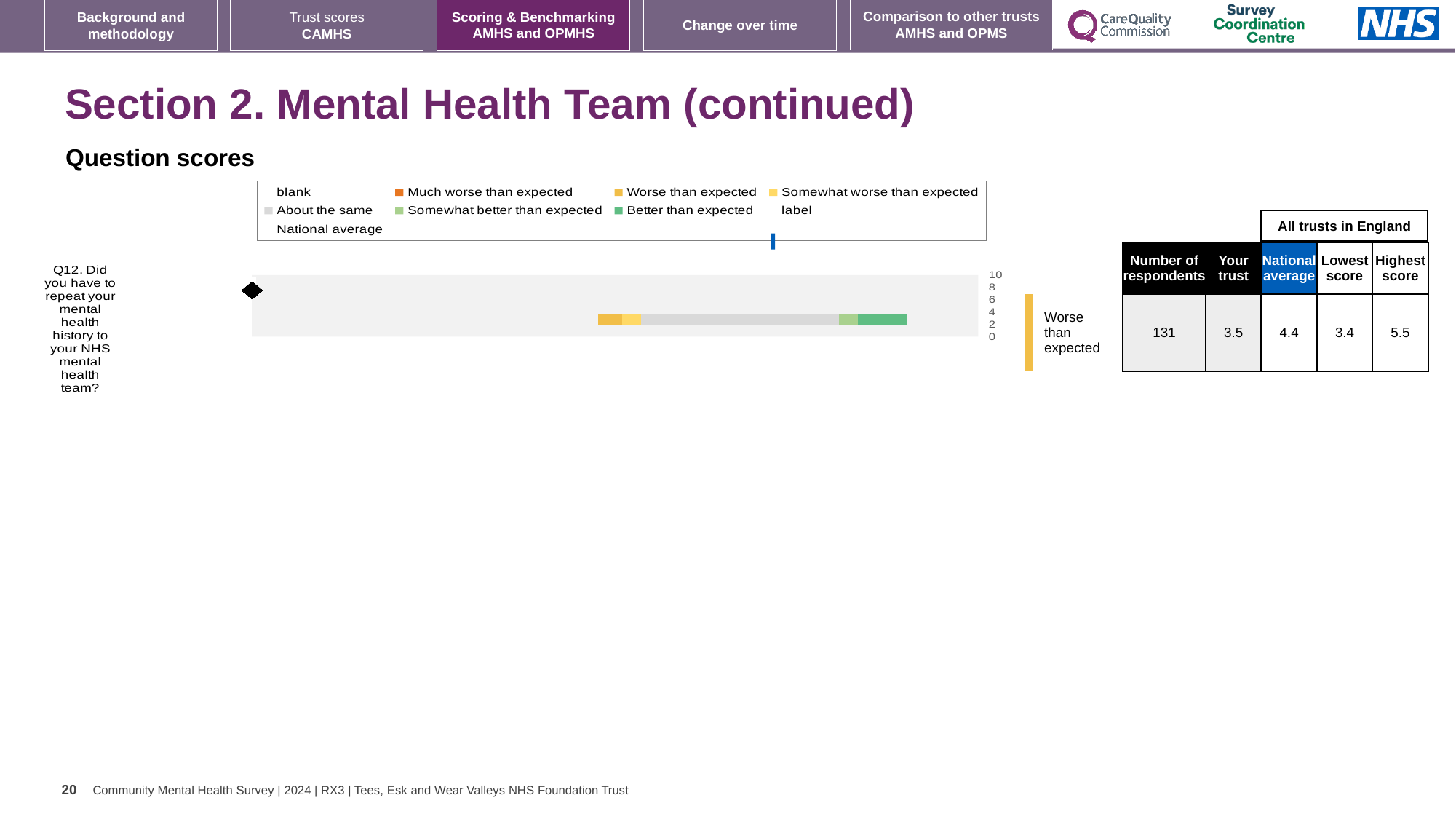
Which is larger for Q12: the trust's score or the national average? National average What benchmark category is shown next to the Q12 bar? Worse than expected What colour does the legend use for 'Better than expected'? Green What is the difference between the national average and the trust's score for Q12? 0.9 What is the 'Your trust' score for Q12 (repeating your mental health history)? 3.5 How many respondents answered Q12? 131 What is the highest score among all trusts in England for Q12? 5.5 What kind of chart is used to show the Q12 question score? bar chart What is the difference between the highest and lowest trust scores for Q12? 2.1 What is the lowest score among all trusts in England for Q12? 3.4 How many questions are plotted in the Question scores chart? 1 What is the national average score for Q12? 4.4